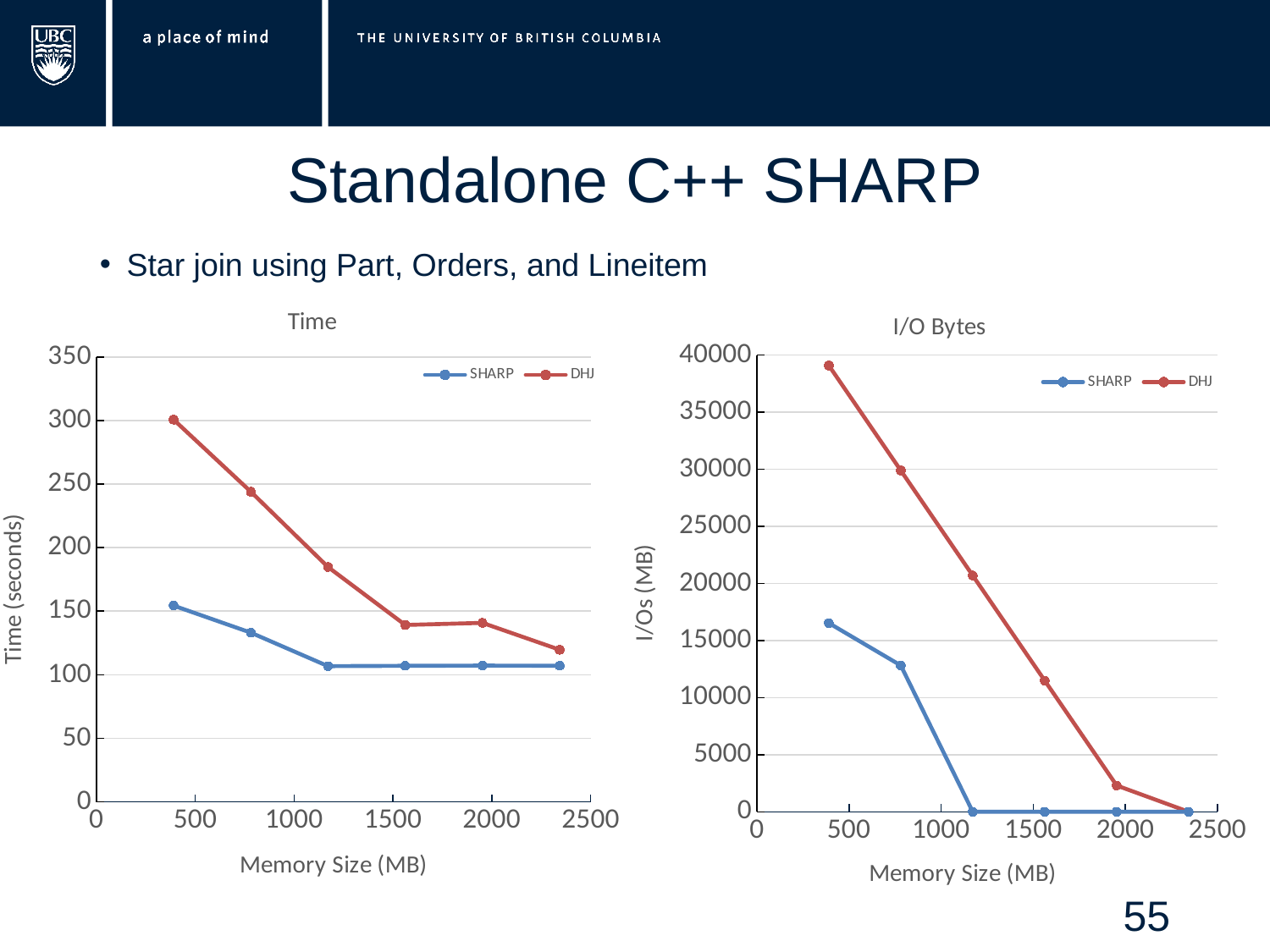
In the Time chart, is the DHJ value at the second data point (around 800 MB) greater or less than 200? greater In the I/O Bytes chart, what is the SHARP value at the largest memory size? 0 In the I/O Bytes chart, is the DHJ value at the smallest memory size greater or less than 35000? greater What is the x-axis label of the I/O Bytes chart? Memory Size (MB) What is the y-axis label of the Time chart? Time (seconds) What type of chart is the Time chart on the left? line chart In the I/O Bytes chart, which series has the lower value at the smallest memory size, SHARP or DHJ? SHARP In the Time chart, how many data points are plotted for the DHJ series? 6 In the Time chart, is the SHARP value at the largest memory size greater or less than 150? less In the I/O Bytes chart, does the DHJ series rise or fall as memory size increases? fall In the Time chart, which series has the higher value at the smallest memory size, SHARP or DHJ? DHJ How many series does the legend of the I/O Bytes chart list? 2